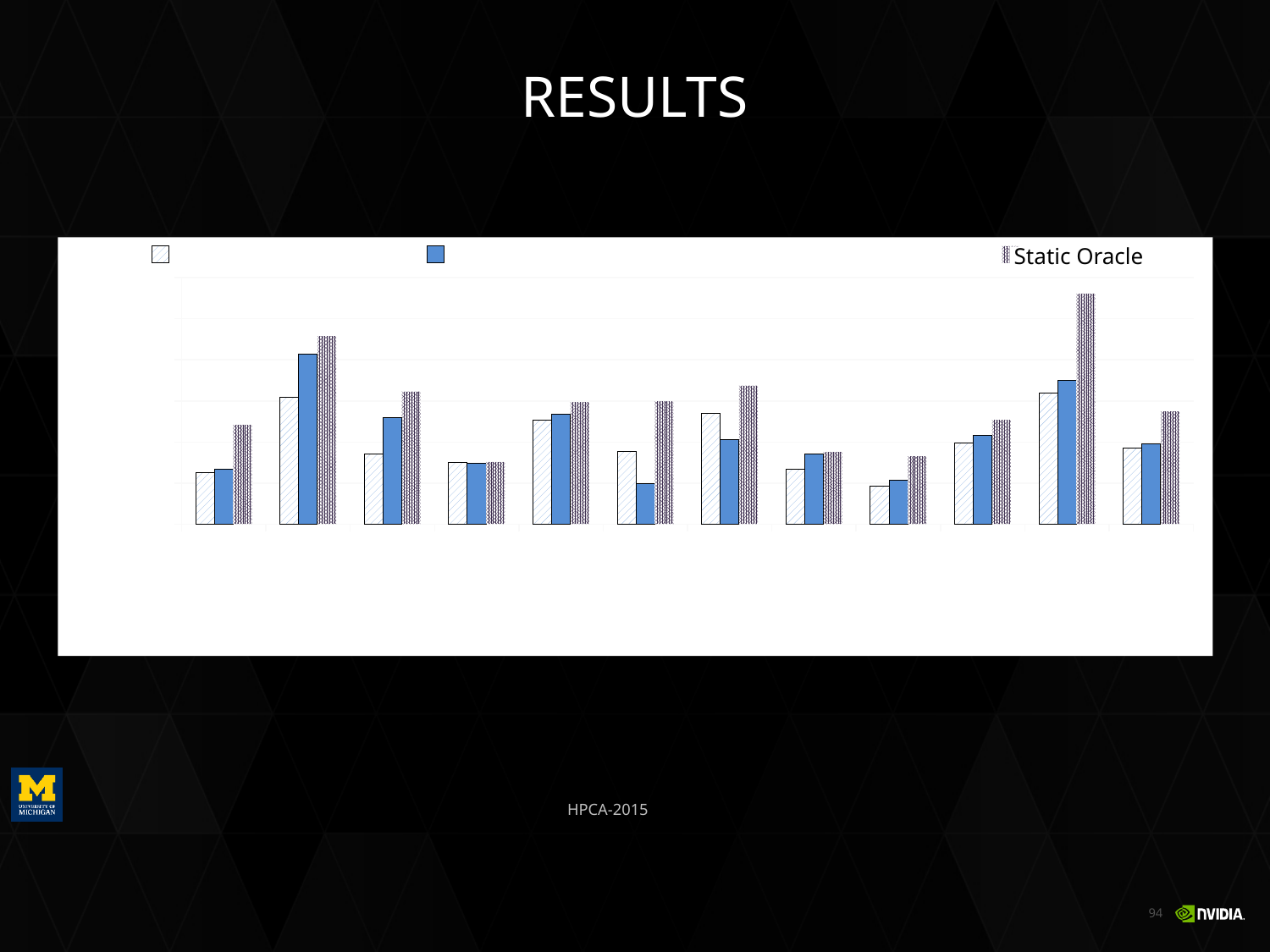
Which legend entry in the chart is readable on the slide? Static Oracle How many series does the chart's legend list? 3 What pattern is used for the Static Oracle series bars in the chart? hatched/patterned fill How many groups of bars are plotted in the chart? 12 What kind of chart is shown on the slide? bar chart Which series contains the single tallest bar in the chart? Static Oracle